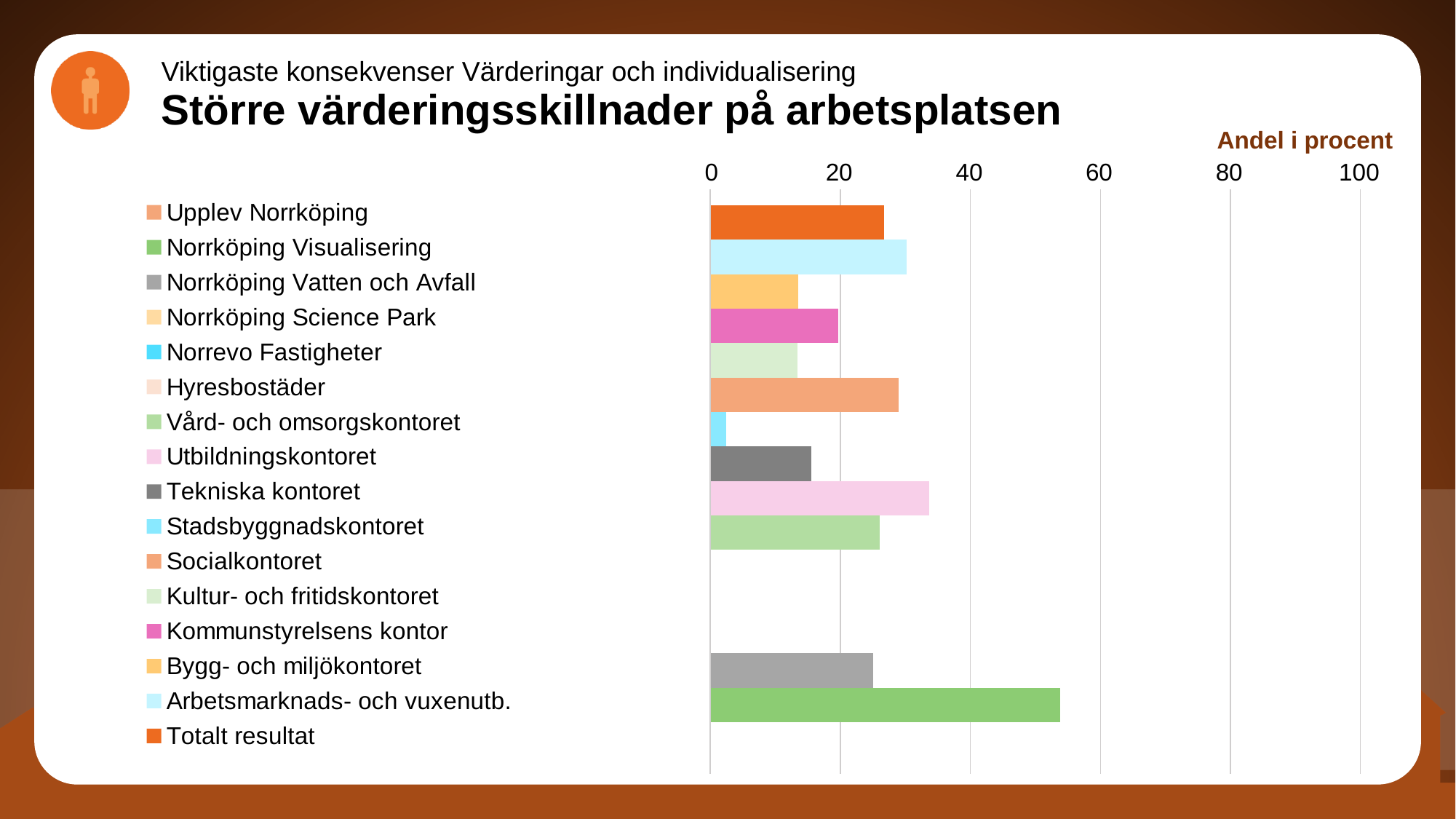
Is the value for Utbildningskontoret greater or less than 20? greater What label is shown above the horizontal axis of the chart? Andel i procent What is the highest value shown on the horizontal axis of the chart? 100 Which is larger, the value for Norrköping Visualisering or the value for Utbildningskontoret? Norrköping Visualisering Which category has the longest bar in the chart? Norrköping Visualisering Is the value for Stadsbyggnadskontoret greater or less than 20? less Is the value for Kommunstyrelsens kontor greater or less than 40? less What kind of chart is shown on the slide? bar chart Which is larger, the value for Utbildningskontoret or the value for Tekniska kontoret? Utbildningskontoret How many entries does the chart legend list? 16